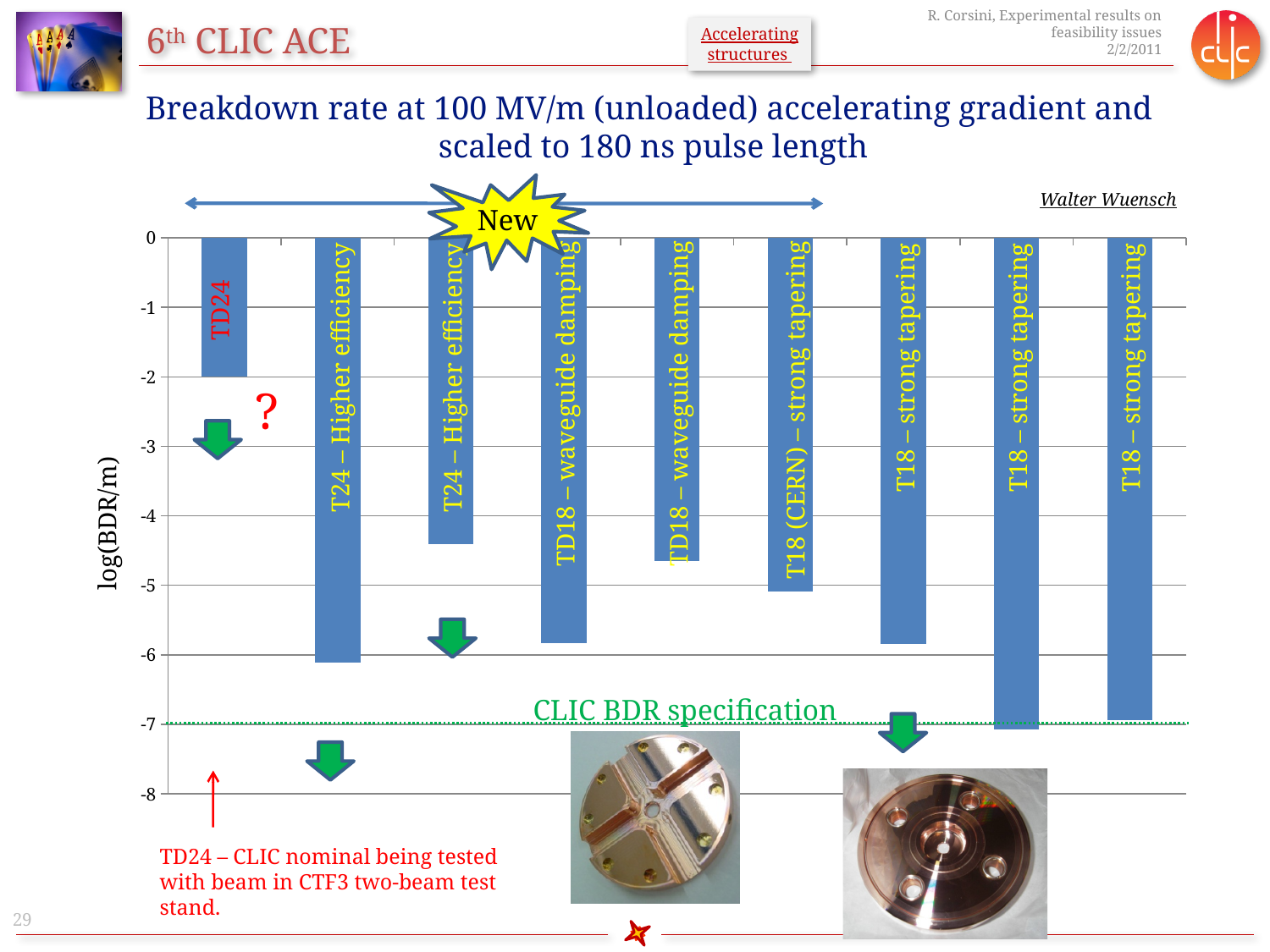
What is the label of the dotted green horizontal line in the chart? CLIC BDR specification What type of chart is shown on the slide? bar chart Is the value for the first 'T24 – Higher efficiency' bar from the left greater or less than -5? less Of the two 'T24 – Higher efficiency' bars, which has the higher (less negative) value: the first or the second from the left? the second Is the value for the second 'T24 – Higher efficiency' bar from the left greater or less than -5? greater Is the value for the TD24 bar greater or less than -3? greater How many bars are plotted in the chart? 9 Which has the higher log(BDR/m) value: the TD24 bar or the 'T18 (CERN) – strong tapering' bar? TD24 What is the label of the vertical axis of the chart? log(BDR/m) Which bar has the highest (least negative) log(BDR/m) value? TD24